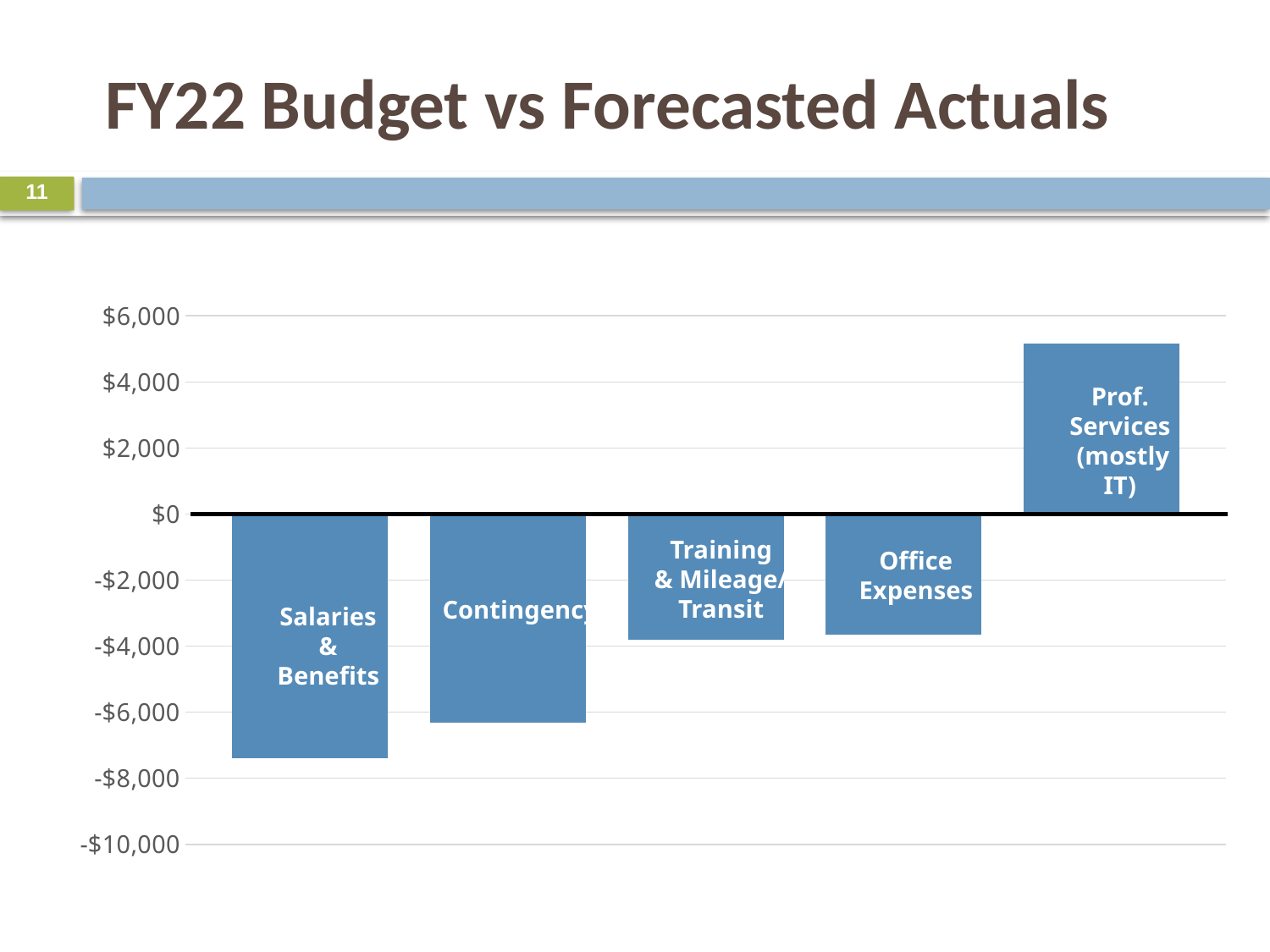
How many categories in the chart have a positive value? 1 Is the value for Contingency greater or less than -$4,000? less Which category has the lowest value in the chart? Salaries & Benefits Is the value for Prof. Services (mostly IT) greater or less than $4,000? greater What kind of chart is shown on the slide? bar chart Is the value for Office Expenses greater or less than -$4,000? greater What is the title of the slide containing the chart? FY22 Budget vs Forecasted Actuals How many categories are plotted in the chart? 5 Which is larger, the value for Salaries & Benefits or the value for Contingency? Contingency Which category has the highest value in the chart? Prof. Services (mostly IT)